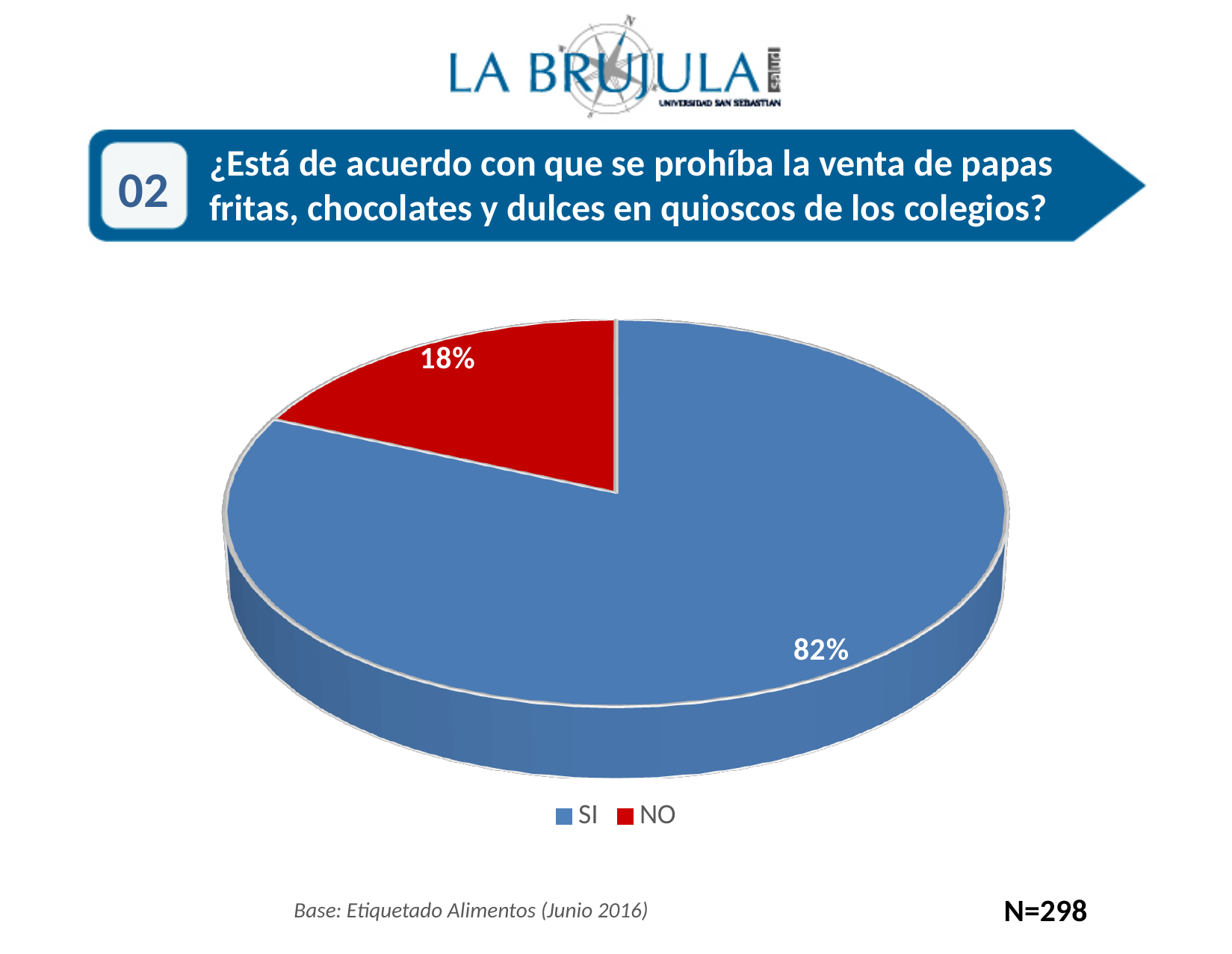
What percentage of respondents answered SI? 82% What is the sample size (N) shown on the slide? N=298 What share of the pie does the NO slice represent? 18% What kind of chart is shown on the slide? Pie chart What is the difference in percentage points between the SI and NO shares? 64 What colour is the SI slice in the pie chart? Blue How many entries does the legend list? 2 Which is larger, the share for SI or the share for NO? SI Which response has the smallest share of the pie? NO Which response has the largest share of the pie? SI How many slices does the pie chart have? 2 What percentage of respondents answered NO? 18%